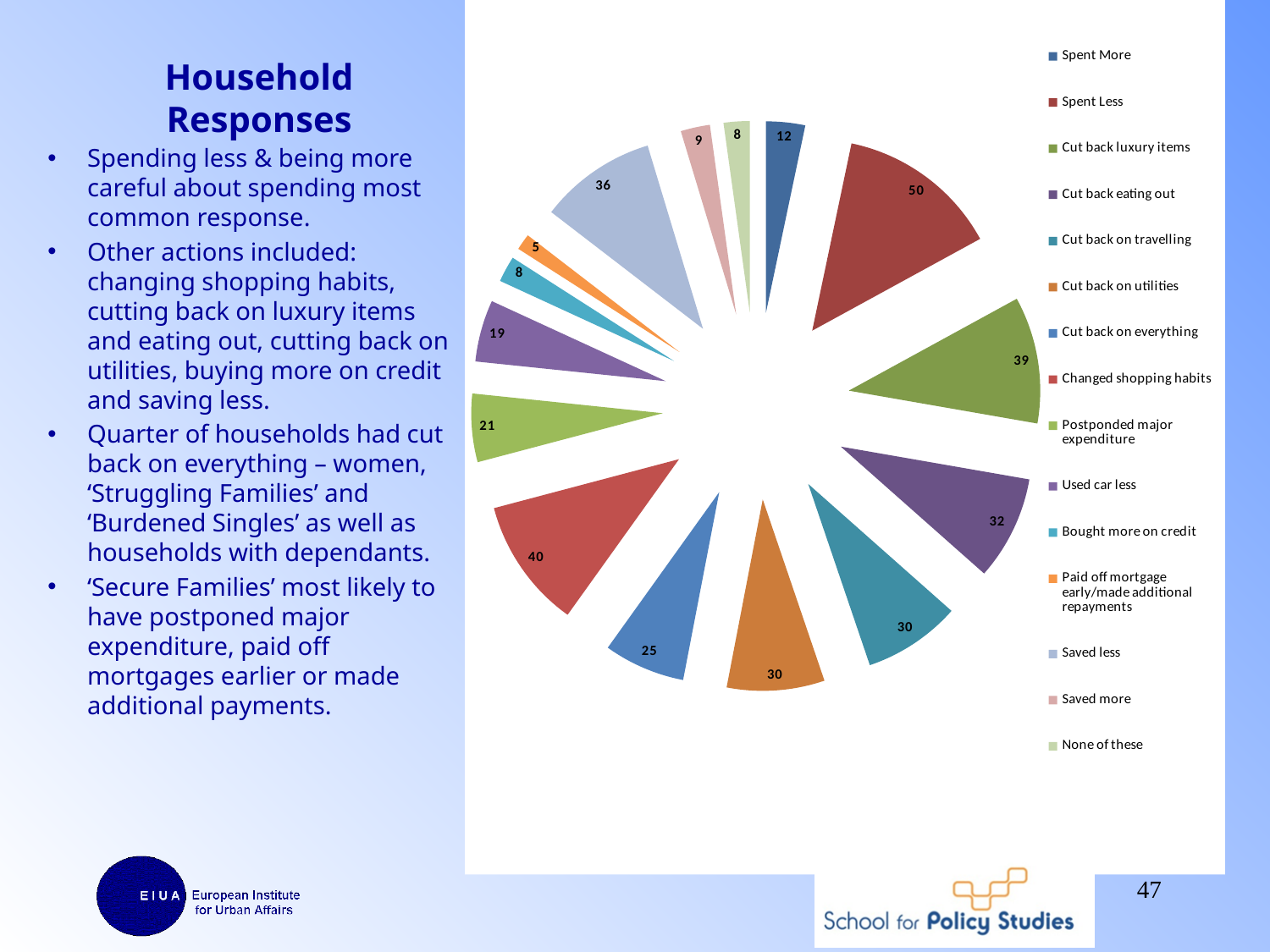
Which legend entry is listed last in the pie chart's legend? None of these What is the difference between the values for Spent Less and Cut back luxury items? 11 What is the difference between the values for Changed shopping habits and Postponded major expenditure? 19 What is the value for Cut back on everything? 25 Which category has the largest slice in the pie chart? Spent Less Which is larger, the value for Cut back eating out or the value for Saved less? Saved less What is the value for Saved less? 36 How many categories does the legend of the pie chart list? 15 Which category has the smallest slice in the pie chart? Paid off mortgage early/made additional repayments What kind of chart is shown on the slide? pie chart What is the value for Spent Less? 50 What is the value for Changed shopping habits? 40